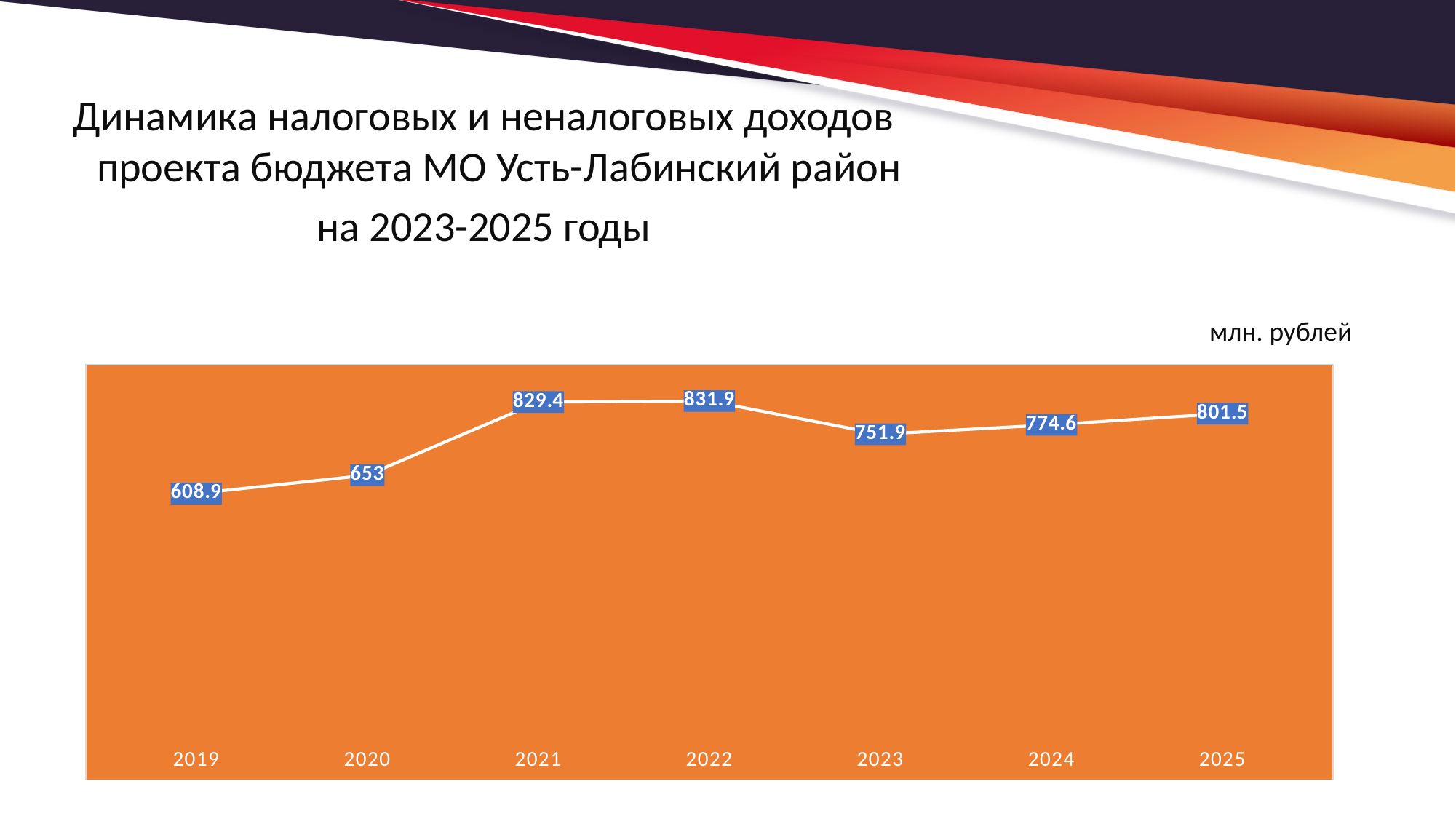
What is the value for 2023? 751.9 What is the value for 2025? 801.5 Which is larger, the value for 2024 or the value for 2025? 2025 Which year has the highest value? 2022 What is the value for 2019? 608.9 What is the difference between the values for 2022 and 2023? 80 How many years are plotted on the chart? 7 What kind of chart is shown on the slide? line chart What is the difference between the values for 2020 and 2019? 44.1 Do the values rise or fall from 2019 to 2021? rise Which year has the lowest value? 2019 What unit is indicated above the chart? млн. рублей